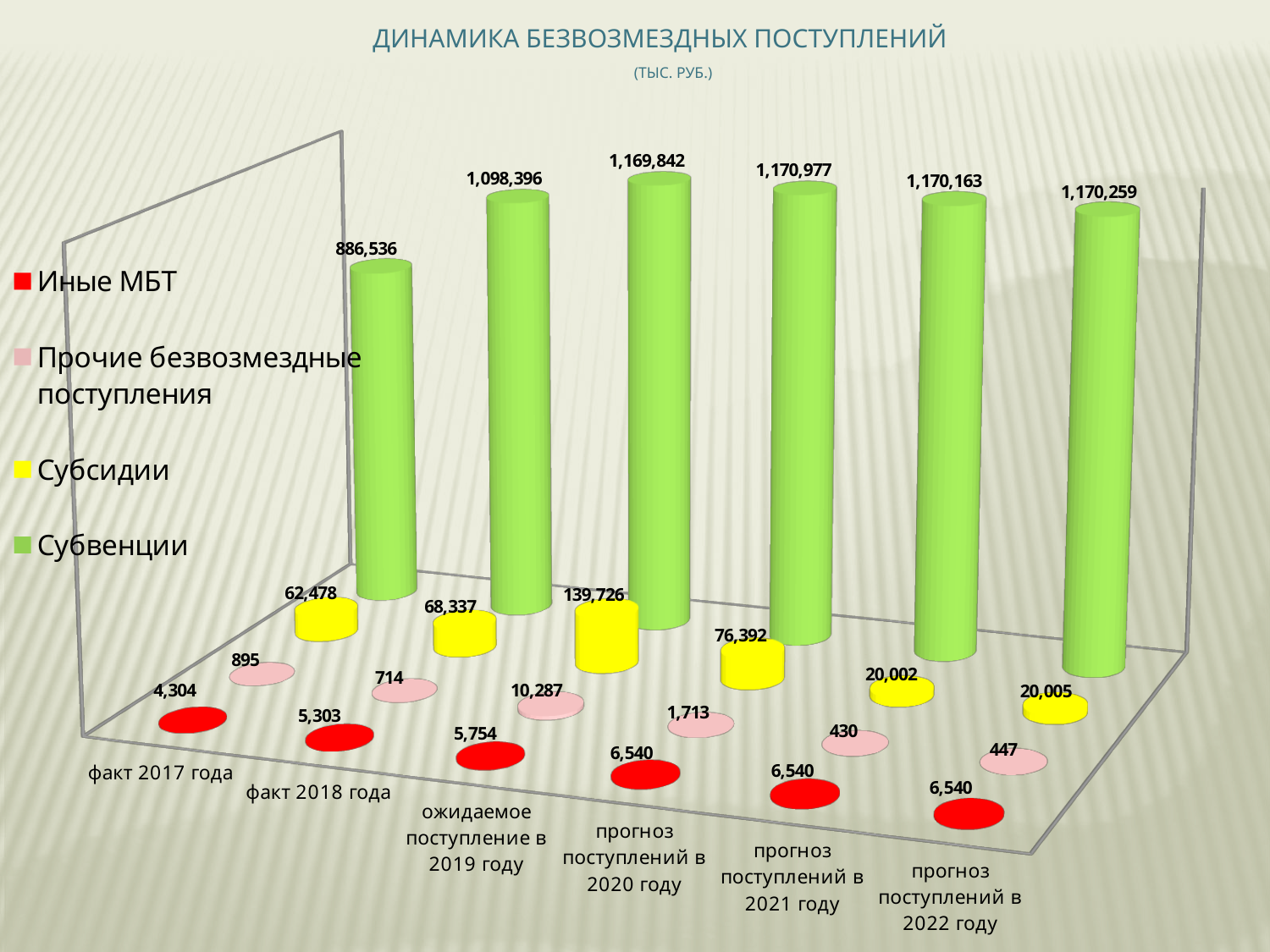
What is the value of Иные МБТ for прогноз поступлений в 2022 году? 6,540 Do the values of Субвенции rise or fall from факт 2017 года to ожидаемое поступление в 2019 году? rise In which category is Прочие безвозмездные поступления lowest? прогноз поступлений в 2021 году What is the value of Прочие безвозмездные поступления for факт 2018 года? 714 What is the value of Субсидии for ожидаемое поступление в 2019 году? 139,726 What kind of chart is shown on the slide? bar chart Which is larger: Субсидии for факт 2017 года or Субсидии for прогноз поступлений в 2020 году? прогноз поступлений в 2020 году In which category is Субвенции highest? прогноз поступлений в 2020 году How many categories are shown on the x axis? 6 What is the difference between Субсидии in ожидаемое поступление в 2019 году and in факт 2018 года? 71,389 How many series does the legend list? 4 What is the value of Субвенции for факт 2017 года? 886,536